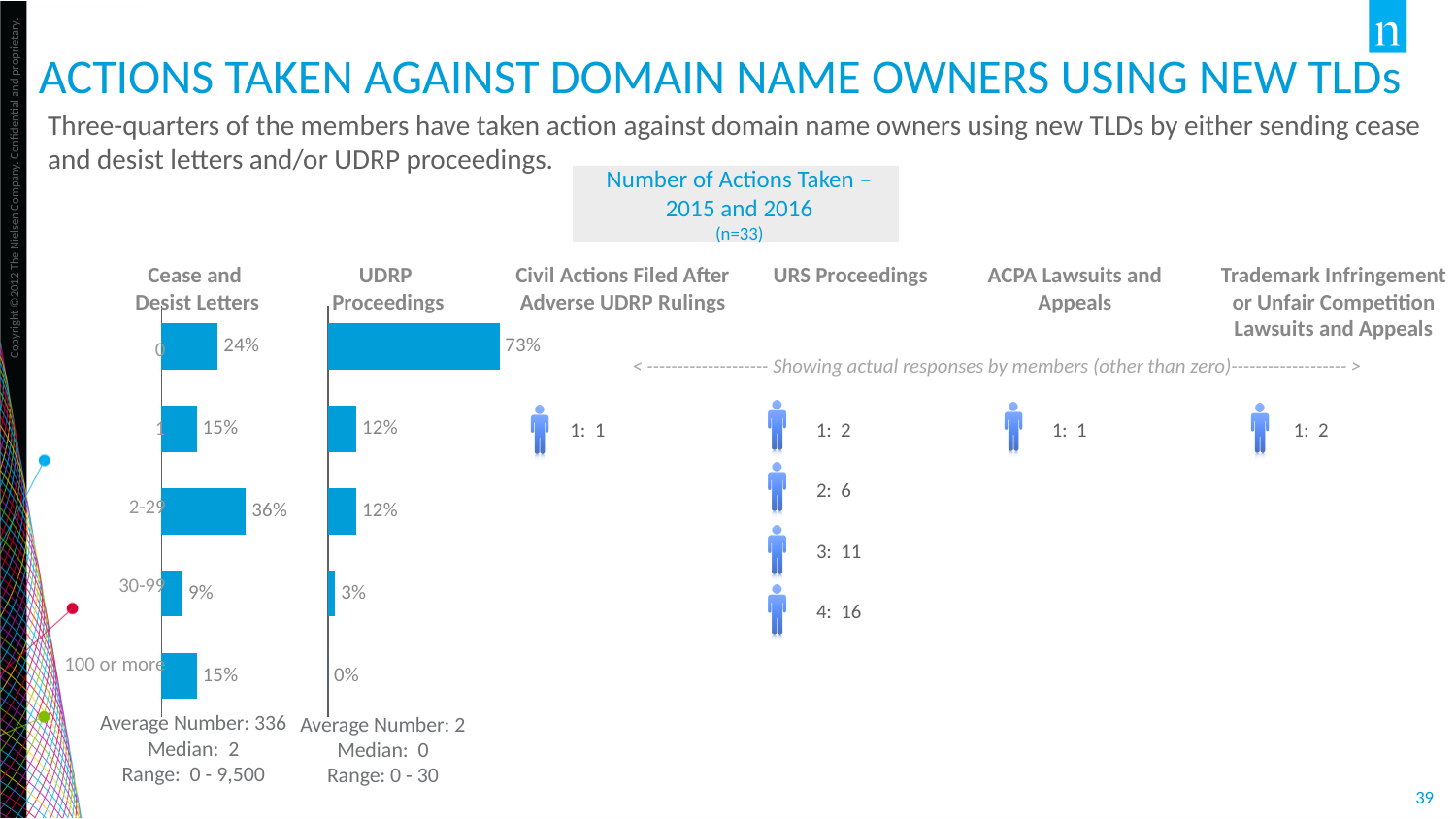
In the UDRP Proceedings chart, what percentage of members had 30-99 proceedings? 3% In the Cease and Desist Letters chart, which category has the highest percentage? 2-29 In the UDRP Proceedings chart, what percentage of members had 0 proceedings? 73% In the Cease and Desist Letters chart, what percentage of members sent 2-29 letters? 36% What is the sample size (n) shown in the chart title box? n=33 What type of chart is used for the UDRP Proceedings data? Bar chart In the Cease and Desist Letters chart, which category has the lowest percentage? 30-99 In the Cease and Desist Letters chart, what percentage of members sent 100 or more letters? 15% In the Cease and Desist Letters chart, which is larger: the value for 0 or the value for 1? 0 What is the difference between the 0 category in the UDRP Proceedings chart and the 0 category in the Cease and Desist Letters chart? 49% How many categories does the Cease and Desist Letters chart show? 5 In the UDRP Proceedings chart, which category has the lowest percentage? 100 or more